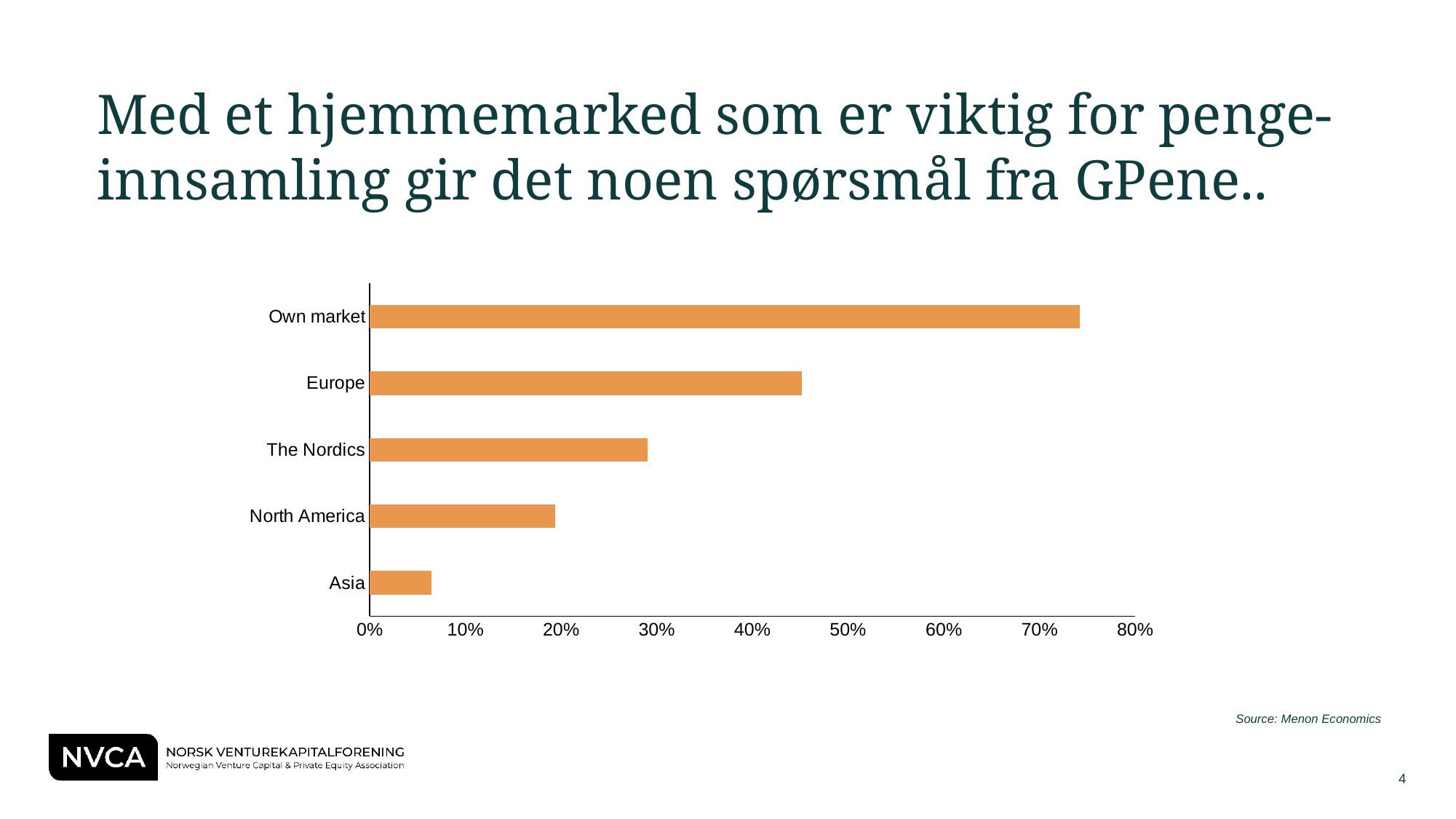
What kind of chart is shown on the slide? bar chart Is the value for Europe greater or less than 40%? greater How many categories are plotted in the chart? 5 Which category has the lowest value in the chart? Asia Which has a larger value, Asia or North America? North America Is the value for Own market greater or less than 70%? greater Is the value for The Nordics greater or less than 20%? greater What is the maximum value shown on the horizontal axis of the chart? 80% Which has a larger value, Europe or The Nordics? Europe Which category has the highest value in the chart? Own market